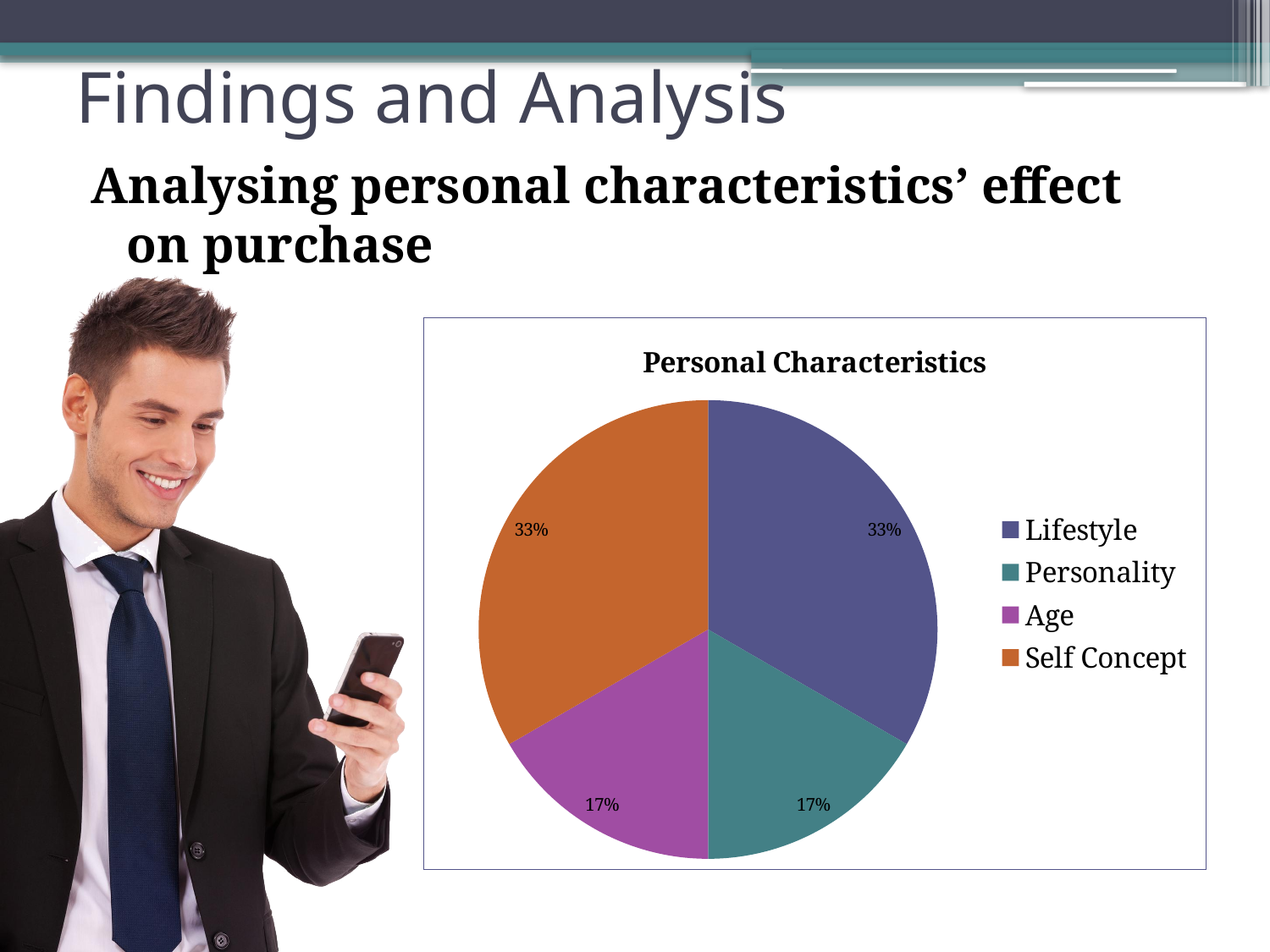
Is the share for Personality greater or less than 25%? less What is the title of the chart? Personal Characteristics What kind of chart is shown on the slide? pie chart What share of the pie does Age represent? 17% What share of the pie does Personality represent? 17% How many categories does the pie chart show? 4 What share of the pie does Lifestyle represent? 33% What is the difference in percentage points between the Lifestyle share and the Age share? 16 percentage points Which is larger, the share for Lifestyle or the share for Personality? Lifestyle What share of the pie does Self Concept represent? 33% Which category is shown in orange in the pie chart? Self Concept Which is larger, the share for Age or the share for Self Concept? Self Concept